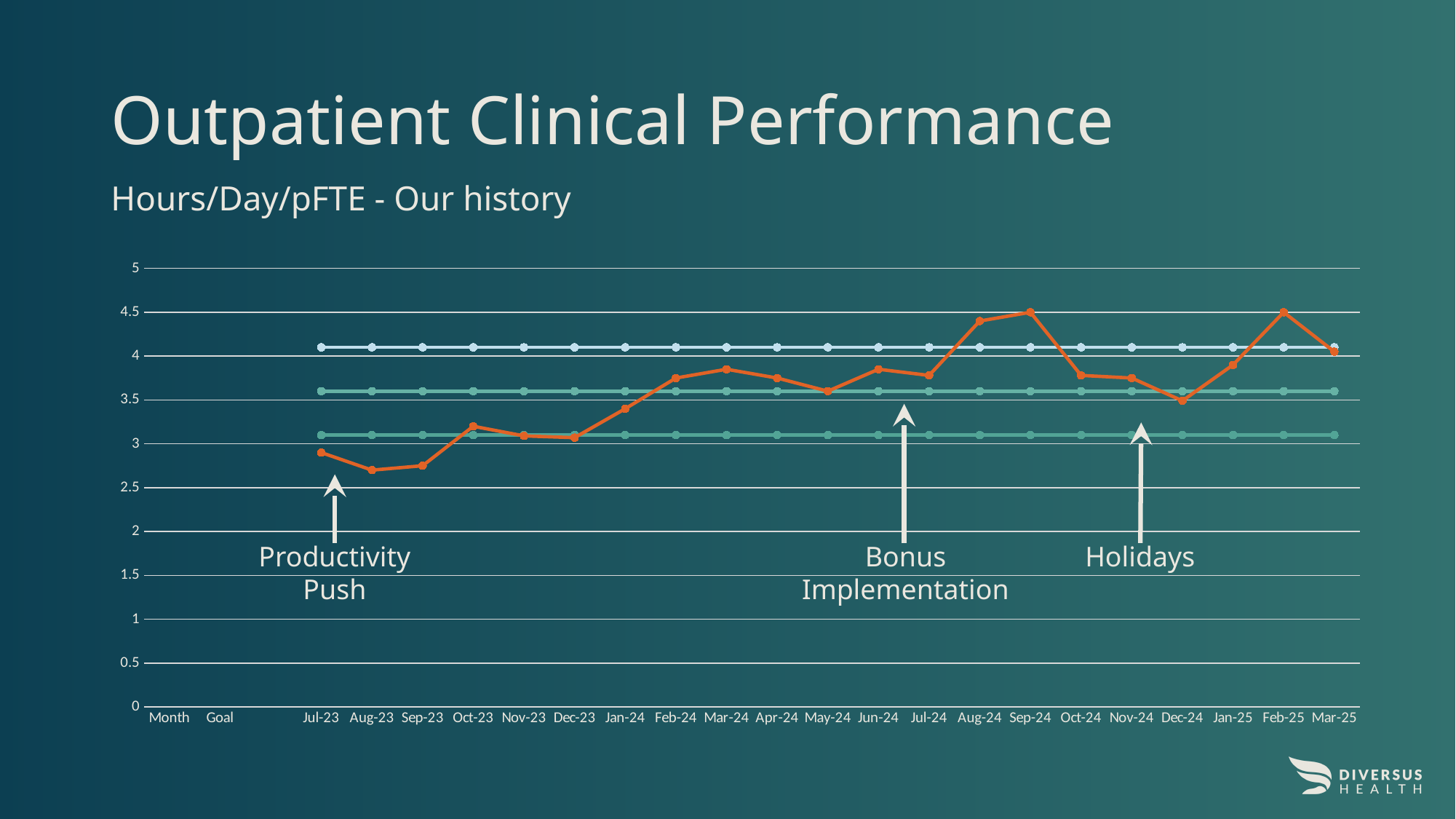
Which has the higher value on the orange line, Sep-24 or Dec-24? Sep-24 Which event is annotated with an arrow at Jul-23 on the chart? Productivity Push What kind of chart is shown on the slide? line chart Is the value of the orange line for Aug-23 greater or less than 3? less Does the orange line generally rise or fall from Jul-23 to Sep-24? rise Is the value of the orange line for Sep-24 greater or less than 4? greater Is the value of the orange line for Dec-24 greater or less than 4? less How many months from Jul-23 to Mar-25 are plotted on the x axis? 21 Which has the higher value on the orange line, Jul-23 or Aug-24? Aug-24 What is the title of the slide containing the chart? Outpatient Clinical Performance